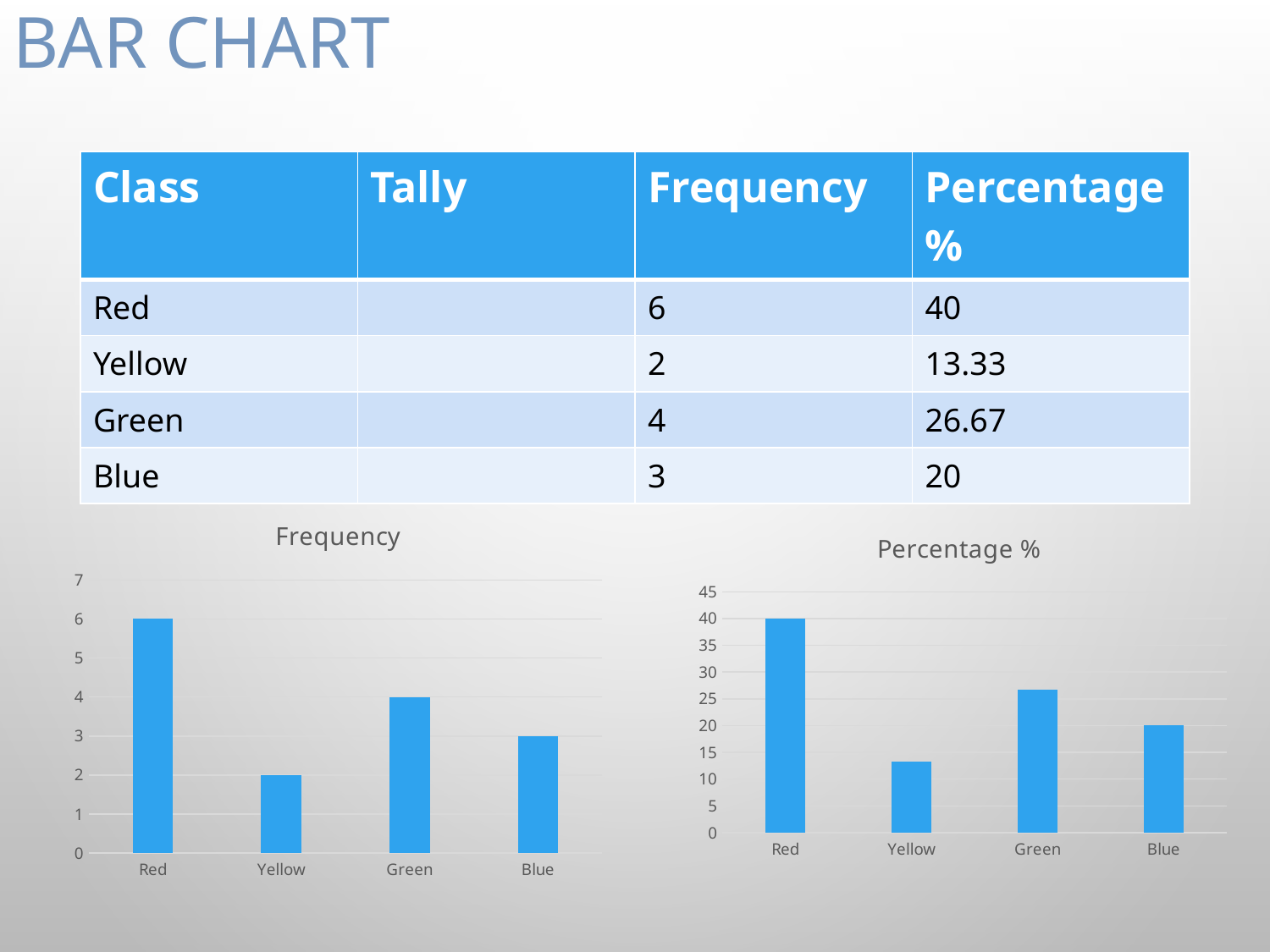
In the Percentage % chart, which is larger, the value for Yellow or the value for Blue? Blue In the Percentage % chart, what is the value for Blue? 20 In the Percentage % chart, what is the value for Red? 40 In the Frequency chart, how many categories are shown on the x axis? 4 In the Percentage % chart, which category has the highest value? Red What kind of chart is the Frequency chart? bar chart In the Frequency chart, which category has the lowest value? Yellow In the Frequency chart, what is the value for Red? 6 In the Frequency chart, what is the value for Green? 4 What is the title of the chart on the right side of the slide? Percentage % In the Frequency chart, what is the difference between the values for Red and Blue? 3 In the Percentage % chart, is the value for Green greater or less than 25? greater